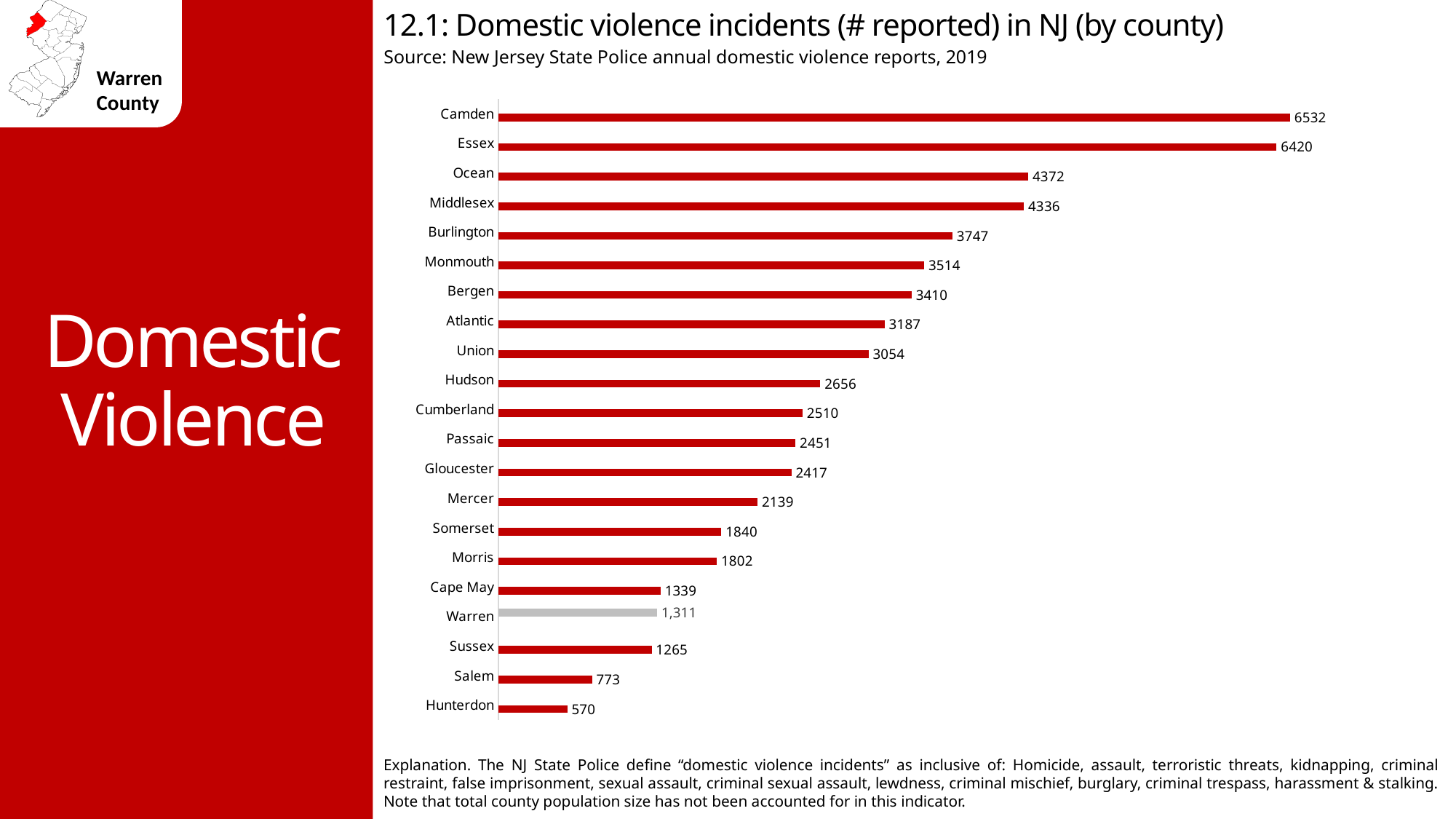
What is the difference in reported incidents between Camden and Essex? 112 Which county has the highest number of reported domestic violence incidents? Camden Which county has the lowest number of reported domestic violence incidents? Hunterdon What is the number of reported domestic violence incidents for Warren County? 1,311 Which county's bar is shown in grey rather than red? Warren Which county has more reported incidents, Salem or Sussex? Sussex What is the number of reported domestic violence incidents for Hunterdon? 570 What kind of chart is used to show domestic violence incidents by county? Bar chart Which county has more reported incidents, Ocean or Middlesex? Ocean What is the number of reported domestic violence incidents for Camden? 6532 What is the difference in reported incidents between Cape May and Sussex? 74 How many counties are shown in the chart? 21